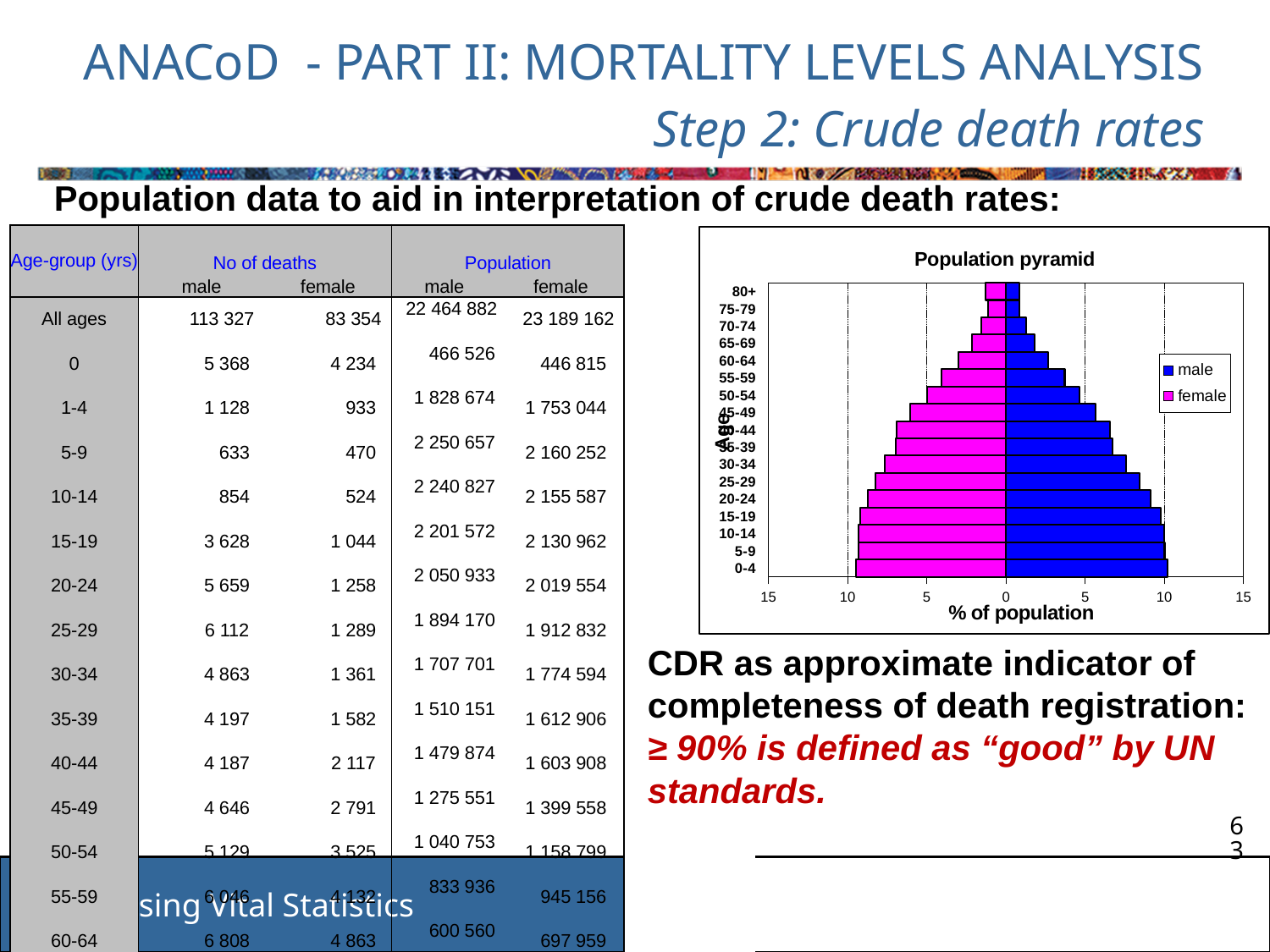
What is the title of the chart on the slide? Population pyramid What kind of chart is the Population pyramid? bar chart In the Population pyramid, is the male value for the 0-4 age group greater or less than 5? greater In the Population pyramid, do the bars generally get longer or shorter as age increases from 0-4 to 80+? shorter In the Population pyramid, is the male value for the 80+ age group greater or less than 5? less How many series does the legend of the Population pyramid list? 2 How many age groups are shown on the Population pyramid? 17 In the Population pyramid, which is larger: the male bar for 40-44 or the male bar for 60-64? 40-44 In the Population pyramid, is the female value for the 60-64 age group greater or less than 5? less What is the label of the horizontal axis of the Population pyramid? % of population In the Population pyramid, which age group has the smallest female bar? 75-79